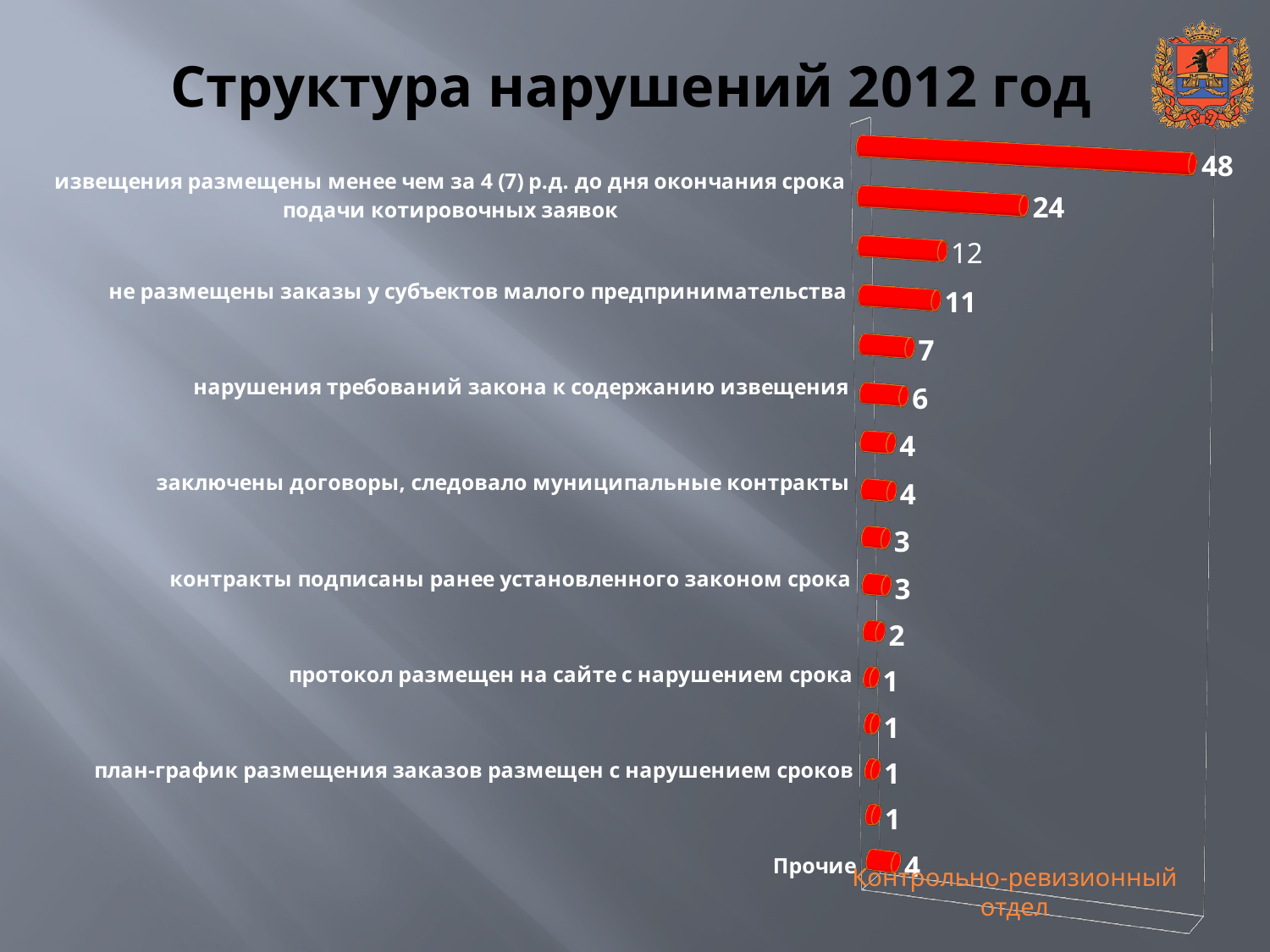
What is the title of the chart? Структура нарушений 2012 год What is the difference between the values for "не размещены заказы у субъектов малого предпринимательства" and "нарушения требований закона к содержанию извещения"? 5 What type of chart is shown on the slide? bar chart Which is larger: "заключены договоры, следовало муниципальные контракты" or "контракты подписаны ранее установленного законом срока"? заключены договоры, следовало муниципальные контракты What is the value for "протокол размещен на сайте с нарушением срока"? 1 What is the value for "контракты подписаны ранее установленного законом срока"? 3 What is the value for "нарушения требований закона к содержанию извещения"? 6 What is the value for "Прочие"? 4 What is the value for "не размещены заказы у субъектов малого предпринимательства"? 11 What is the largest value shown on the chart? 48 How many bars are plotted on the chart? 16 What is the value for "извещения размещены менее чем за 4 (7) р.д. до дня окончания срока подачи котировочных заявок"? 24